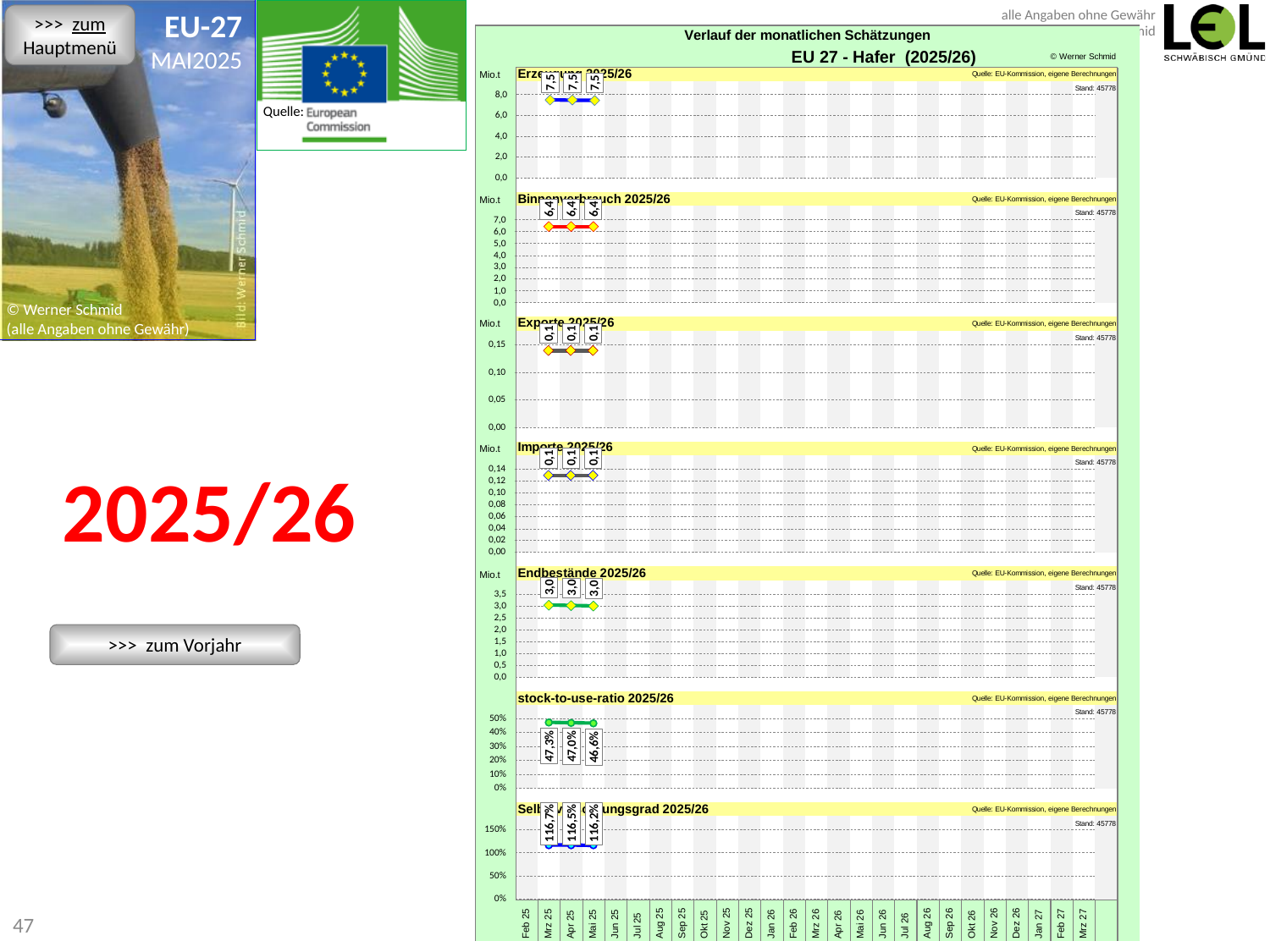
In the 'Selbstversorgungsgrad 2025/26' chart, what is the value of the middle data point? 116,5% How many data points are plotted in the 'Erzeugung 2025/26' chart? 3 What type of chart is the 'Endbestände 2025/26' chart? line chart In the 'Endbestände 2025/26' chart, what value is printed on the data points? 3,0 What is the overall title shown above the charts on the right side of the slide? Verlauf der monatlichen Schätzungen In the 'stock-to-use-ratio 2025/26' chart, what is the value of the last (rightmost) data point? 46,6% In the 'stock-to-use-ratio 2025/26' chart, do the values rise or fall from left to right? fall In the 'Binnenverbrauch 2025/26' chart, what is the value labelled on the data points? 6,4 In the 'stock-to-use-ratio 2025/26' chart, what is the value of the first (leftmost) data point? 47,3% In the 'Erzeugung 2025/26' chart, what value is shown for the data points? 7,5 In the 'Selbstversorgungsgrad 2025/26' chart, what is the difference between the first value (116,7%) and the last value (116,2%)? 0,5% In the 'Erzeugung 2025/26' chart, is the plotted value greater or less than 6,0? greater